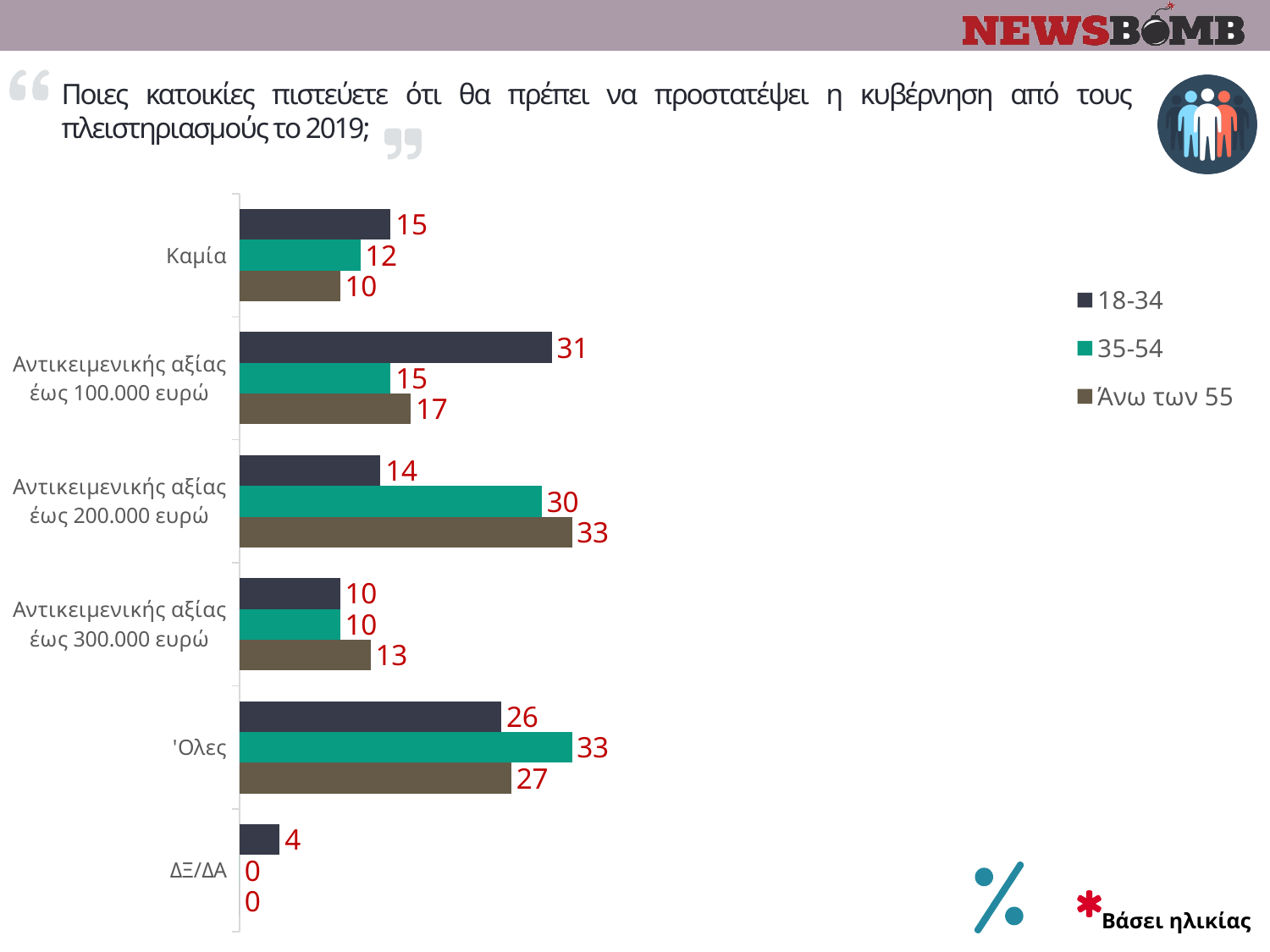
How many series does the legend list? 3 What is the value for the 35-54 series in the 'Όλες' category? 33 In the 'Καμία' category, which is larger: the 18-34 value or the 'Άνω των 55' value? 18-34 What is the value for the 18-34 series in the 'Αντικειμενικής αξίας έως 100.000 ευρώ' category? 31 Which category has the lowest value for the 'Άνω των 55' series? ΔΞ/ΔΑ Which category has the highest value for the 18-34 series? Αντικειμενικής αξίας έως 100.000 ευρώ Which legend entry is shown in green? 35-54 What is the value for the 35-54 series in the 'ΔΞ/ΔΑ' category? 0 What is the difference between the 18-34 and 35-54 values in the 'Αντικειμενικής αξίας έως 100.000 ευρώ' category? 16 How many categories are shown on the chart? 6 What is the value for the 'Άνω των 55' series in the 'Αντικειμενικής αξίας έως 200.000 ευρώ' category? 33 What kind of chart is shown on the slide? Bar chart